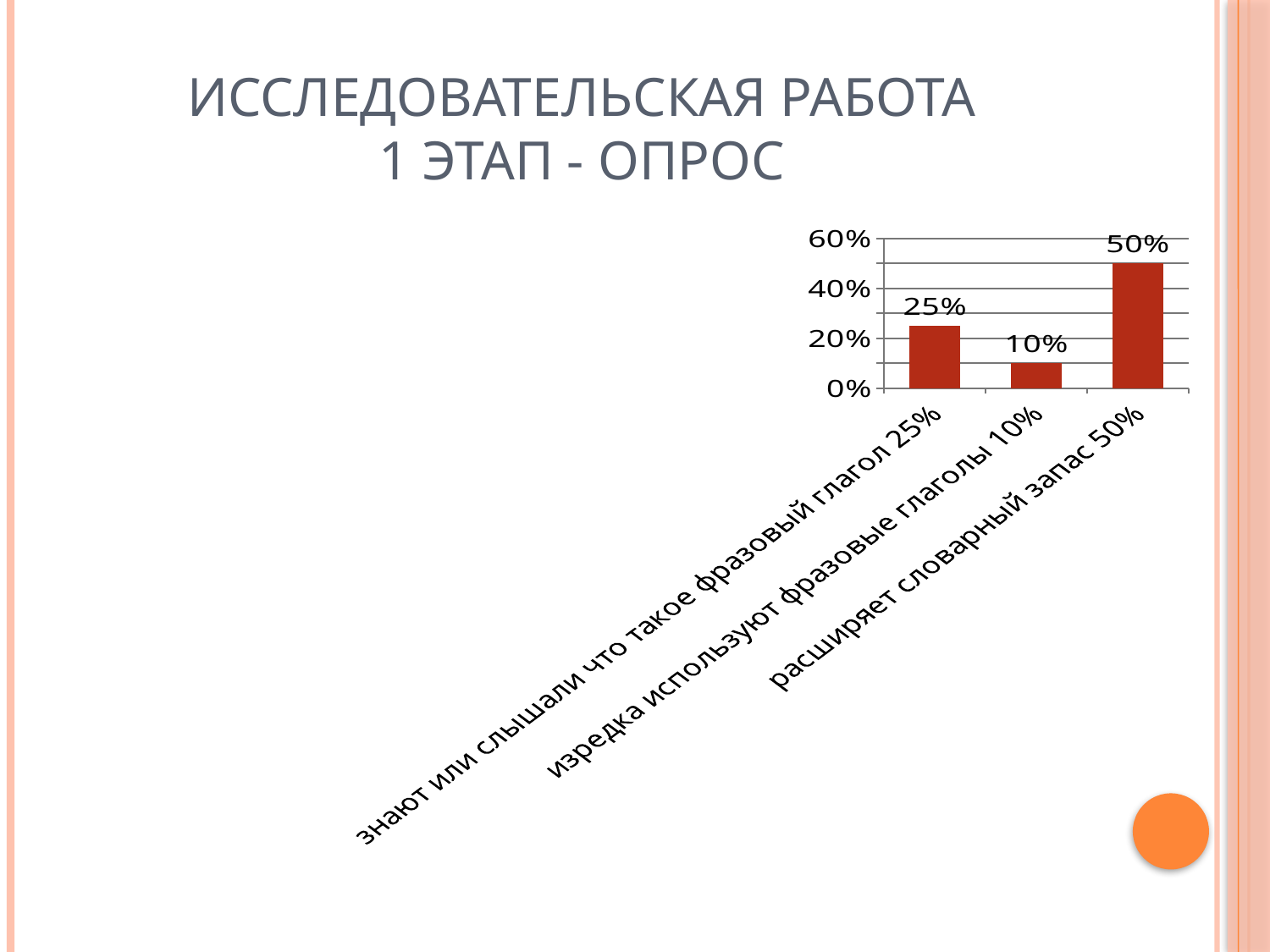
What value is shown for the category "знают или слышали что такое фразовый глагол 25%"? 25% How many categories are shown in the chart? 3 What is the difference between the values for "расширяет словарный запас 50%" and "знают или слышали что такое фразовый глагол 25%"? 25% Is the value for "расширяет словарный запас 50%" greater or less than 40%? greater Which is larger: the value for "знают или слышали что такое фразовый глагол 25%" or the value for "изредка используют фразовые глаголы 10%"? знают или слышали что такое фразовый глагол 25% What value is shown for the category "расширяет словарный запас 50%"? 50% What value is shown for the category "изредка используют фразовые глаголы 10%"? 10% Which category has the highest value? расширяет словарный запас 50% What is the highest value shown on the vertical axis? 60% What is the difference between the values for "знают или слышали что такое фразовый глагол 25%" and "изредка используют фразовые глаголы 10%"? 15% What kind of chart is shown on the slide? bar chart Which category has the lowest value? изредка используют фразовые глаголы 10%